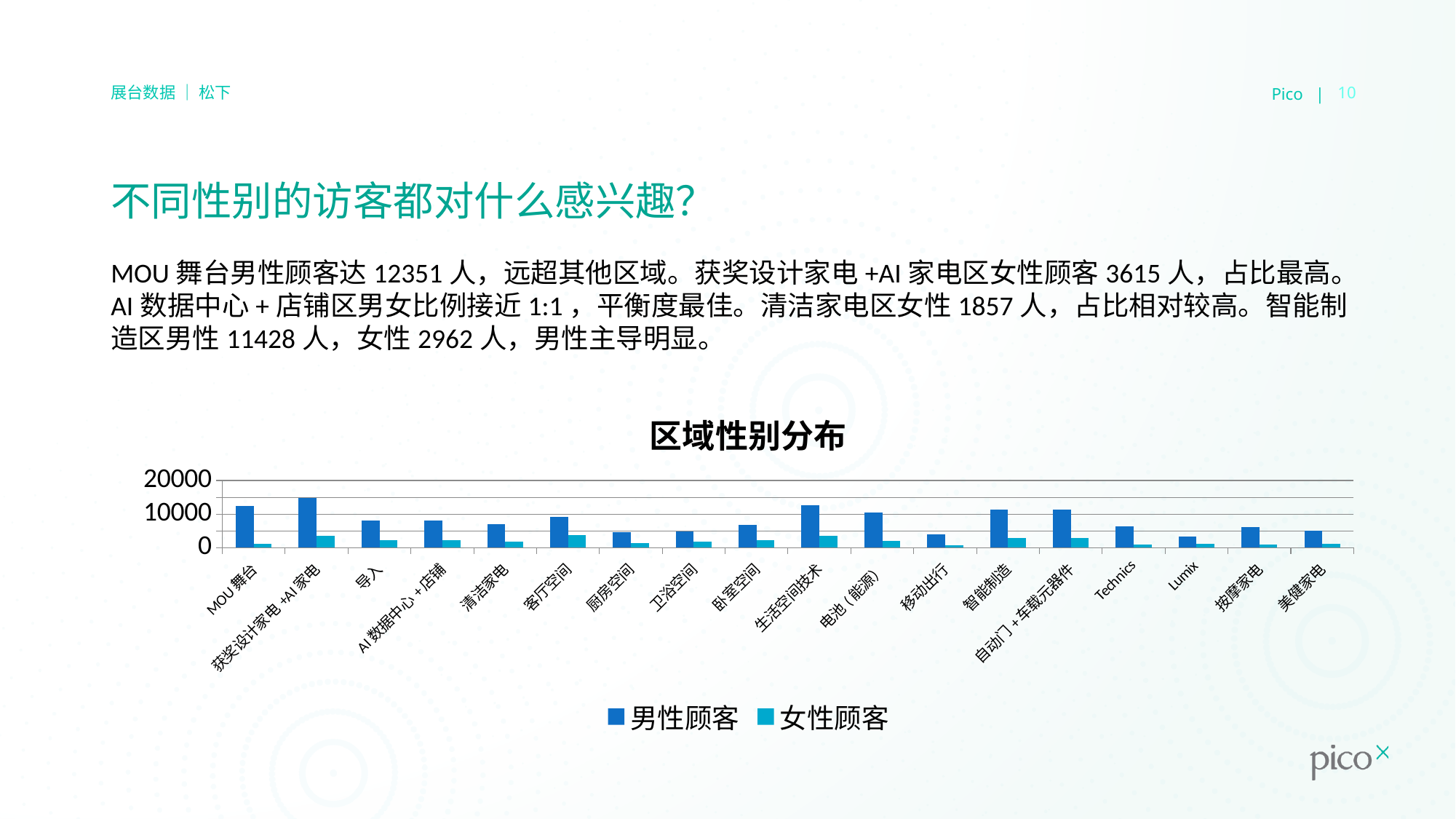
How many series does the chart legend list? 2 Which is larger, the 男性顾客 value for 生活空间技术 or for 卫浴空间? 生活空间技术 What kind of chart is shown on the slide? bar chart Is the 男性顾客 value for MOU 舞台 greater or less than 10000? greater How many categories are shown on the x axis of the chart? 18 Which series is shown in the lighter teal colour in the chart? 女性顾客 According to the slide, what is the difference between 男性顾客 and 女性顾客 for 智能制造? 8466 Is the 男性顾客 value for 厨房空间 greater or less than 10000? less Which is larger for 智能制造, the 男性顾客 value or the 女性顾客 value? 男性顾客 What is the title of the chart? 区域性别分布 According to the slide, how many 男性顾客 did 智能制造 have? 11428 Is the 女性顾客 value for 获奖设计家电 +AI 家电 greater or less than 10000? less